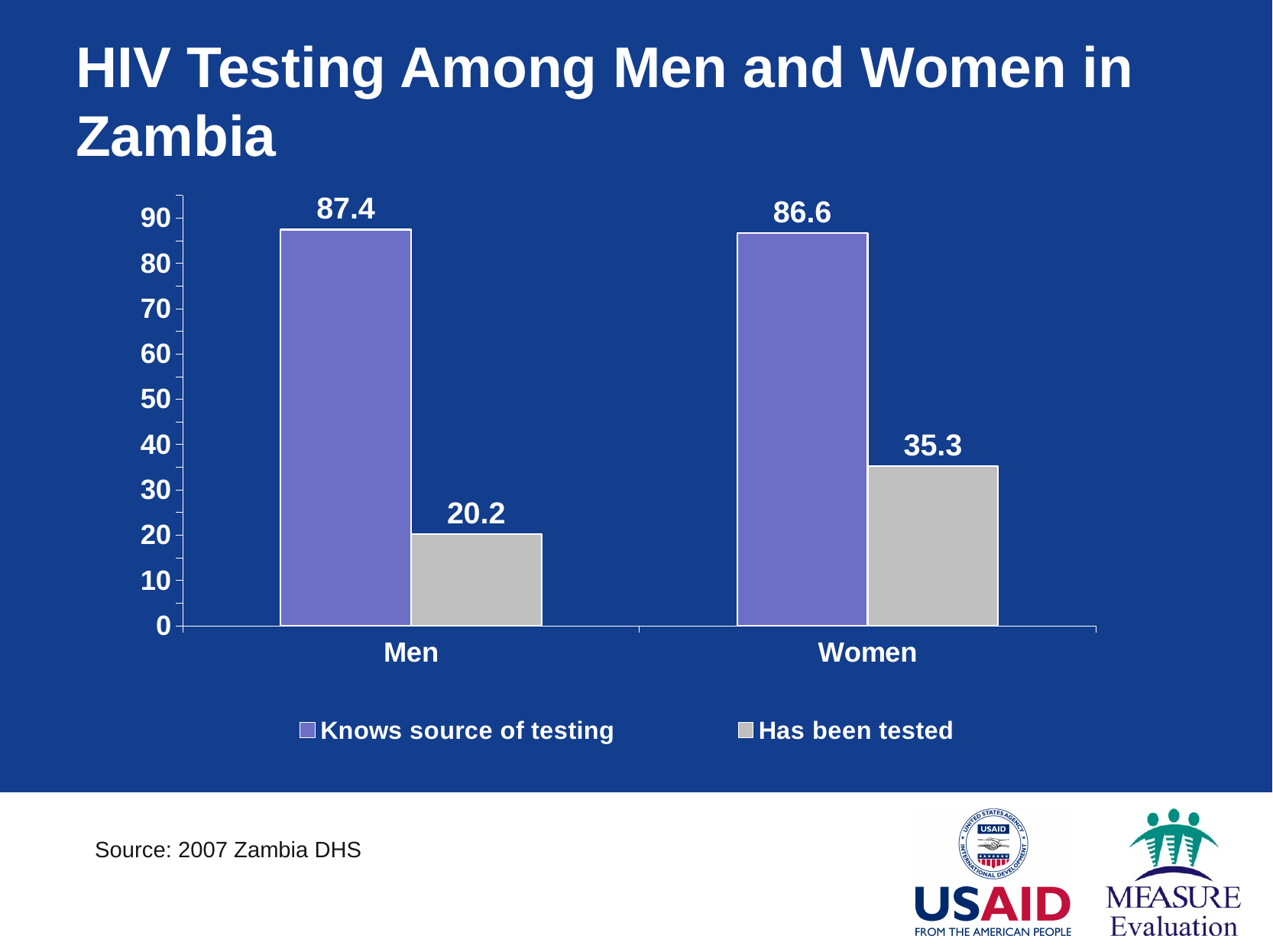
What is the difference between 'Knows source of testing' and 'Has been tested' for Men? 67.2 Which bar has the lowest value on the chart? Has been tested, Men Which group has the higher value for 'Has been tested', Men or Women? Women What is the value for 'Has been tested' among Women? 35.3 What kind of chart is shown on the slide? Bar chart Is the value for 'Has been tested' among Women greater or less than 30? greater What is the value for 'Has been tested' among Men? 20.2 What is the difference between 'Has been tested' for Women and for Men? 15.1 What is the value for 'Knows source of testing' among Women? 86.6 What is the value for 'Knows source of testing' among Men? 87.4 How many categories are shown on the x axis? 2 How many series does the legend list? 2